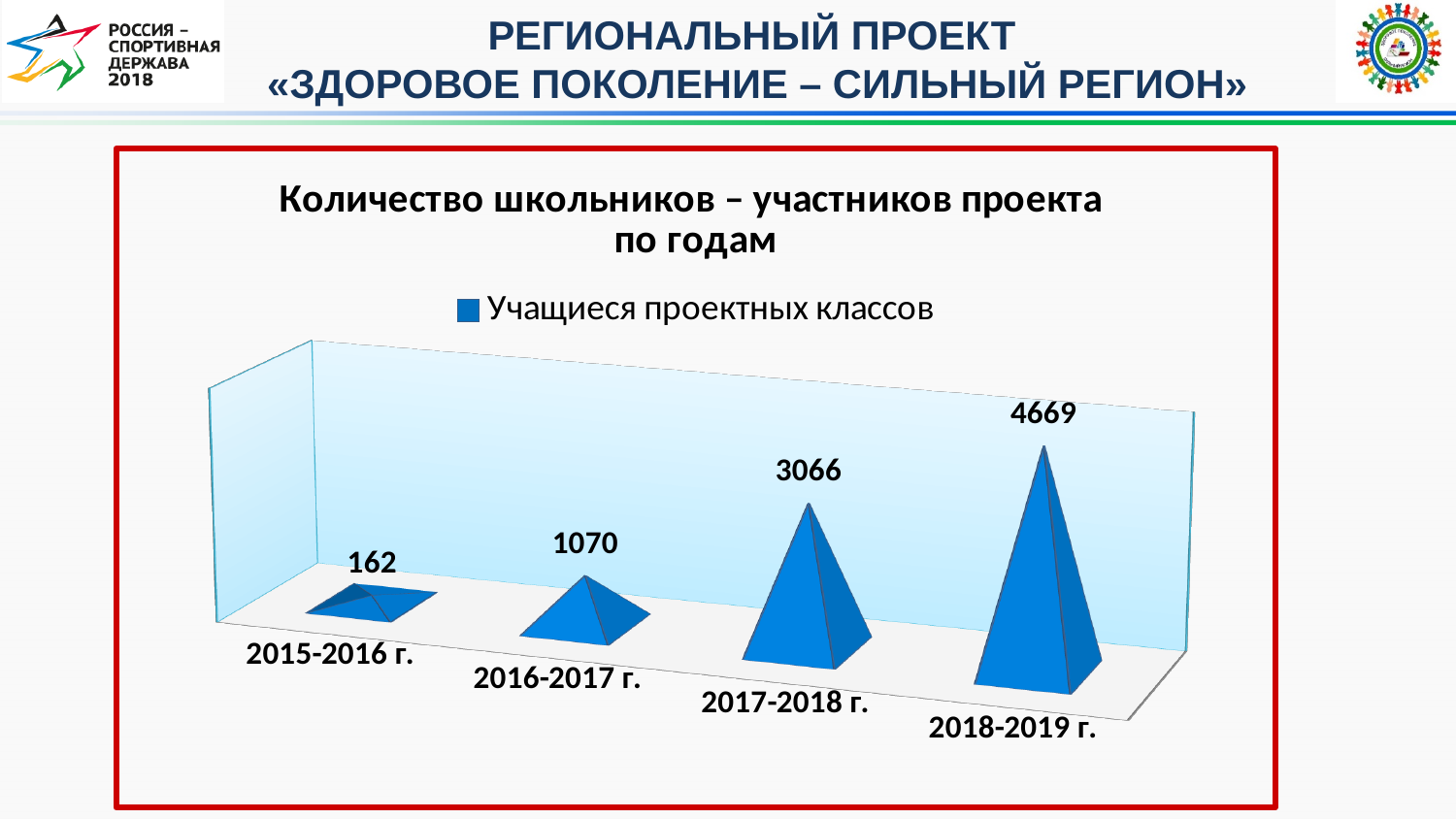
Which year has the lowest number of participating schoolchildren? 2015-2016 г. Do the values rise or fall from 2015-2016 г. to 2018-2019 г.? rise What is the difference between the values for 2016-2017 г. and 2015-2016 г.? 908 What series name is listed in the chart legend? Учащиеся проектных классов What is the value for 2015-2016 г.? 162 What is the value for 2017-2018 г.? 3066 What is the value for 2018-2019 г.? 4669 Which year has the highest number of participating schoolchildren? 2018-2019 г. What is the value for 2016-2017 г.? 1070 Which is larger, the value for 2017-2018 г. or the value for 2016-2017 г.? 2017-2018 г. What is the difference between the values for 2018-2019 г. and 2017-2018 г.? 1603 How many categories (years) are shown on the chart? 4